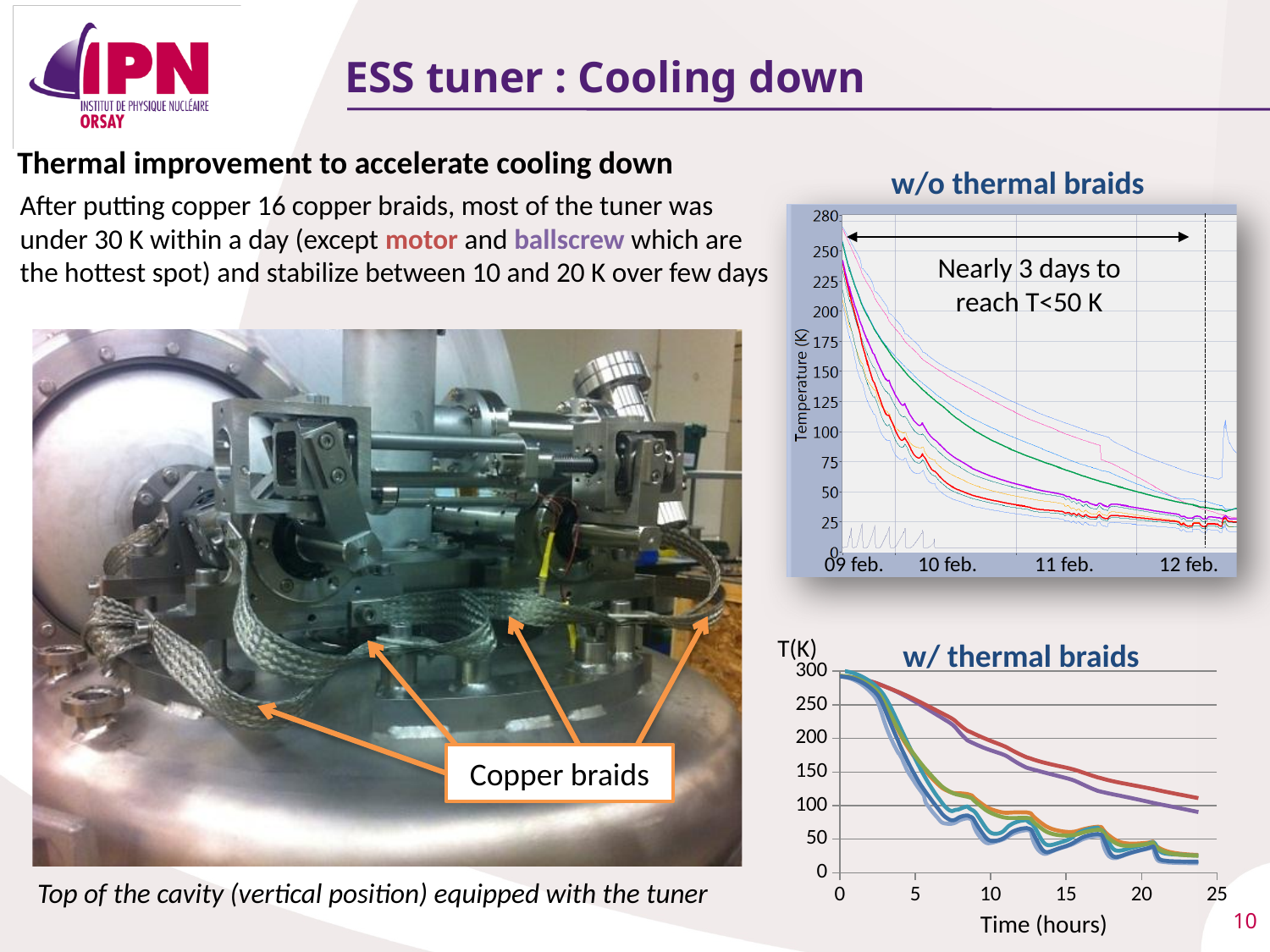
In the 'w/o thermal braids' chart, are the values of all lines at 12 feb. greater or less than 50? less In the 'w/o thermal braids' chart, do the temperature values rise or fall from 09 feb. to 12 feb.? fall What kind of chart is the 'w/o thermal braids' chart? line chart In the 'w/ thermal braids' chart, which line is higher at 20 hours, the red line or the purple line? red line What is the x-axis label of the 'w/ thermal braids' chart? Time (hours) What kind of chart is the 'w/ thermal braids' chart? line chart In the 'w/ thermal braids' chart, is the value of the red line at 20 hours greater or less than 100? greater In the 'w/ thermal braids' chart, are the values of the blue lines at 10 hours greater or less than 100? less What annotation text is written inside the 'w/o thermal braids' chart? Nearly 3 days to reach T<50 K In the 'w/ thermal braids' chart, do the temperature values rise or fall as time increases? fall